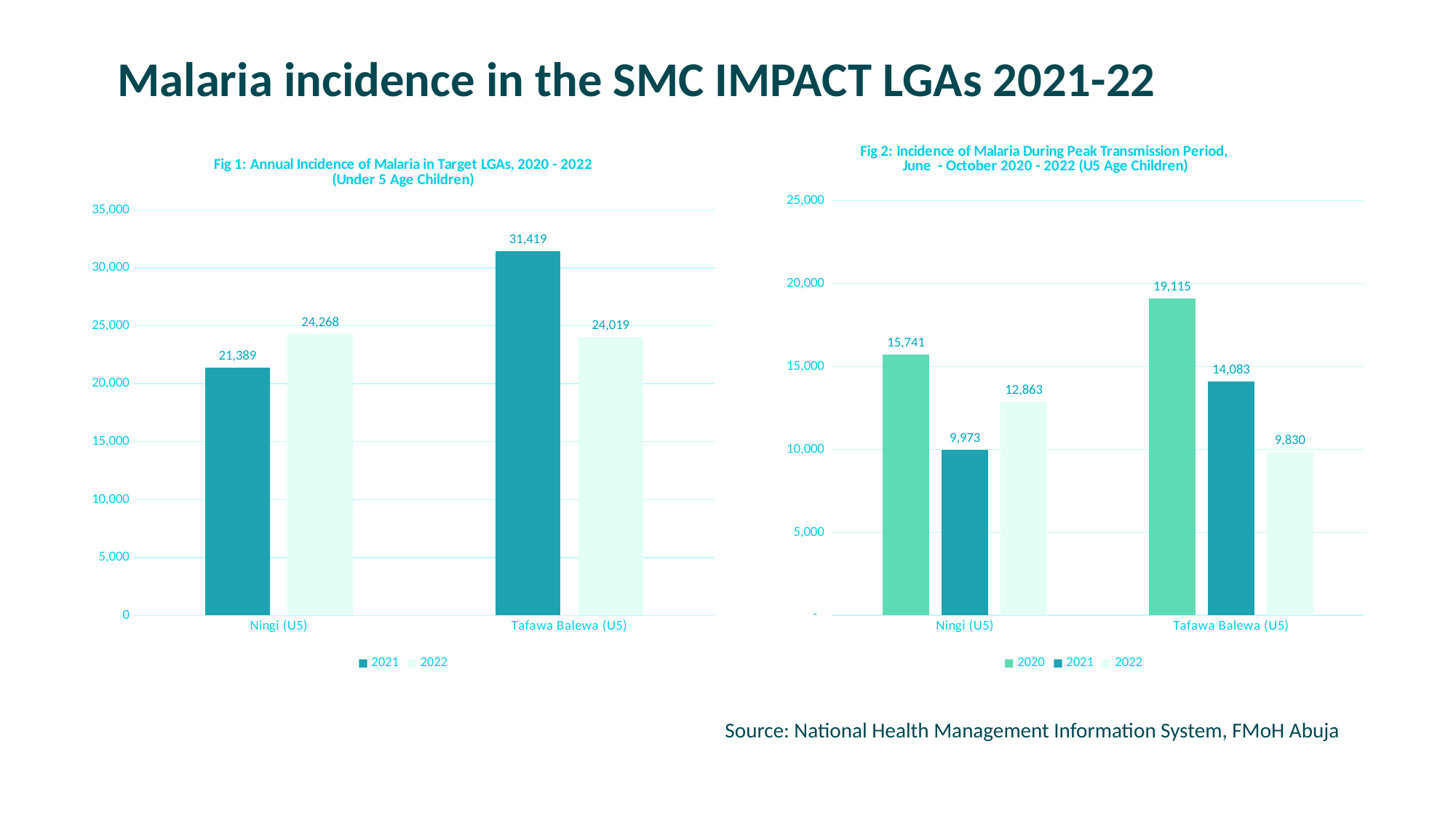
In Fig 1, what is the difference between the 2021 and 2022 values for Tafawa Balewa (U5)? 7,400 In Fig 1, how many series does the legend list? 2 In Fig 1, what is the 2021 value for Ningi (U5)? 21,389 In Fig 2, which bar is the lowest? Tafawa Balewa (U5) 2022 In Fig 2, how many series does the legend list? 3 In Fig 1, is the 2022 value for Ningi (U5) greater or less than 25,000? less What kind of chart is Fig 2? bar chart In Fig 1, which bar is the highest? Tafawa Balewa (U5) 2021 In Fig 1, what is the 2022 value for Tafawa Balewa (U5)? 24,019 In Fig 2, what is the 2022 value for Ningi (U5)? 12,863 In Fig 2, what is the 2020 value for Tafawa Balewa (U5)? 19,115 In Fig 2, which is larger: the 2021 value for Ningi (U5) or the 2021 value for Tafawa Balewa (U5)? Tafawa Balewa (U5)